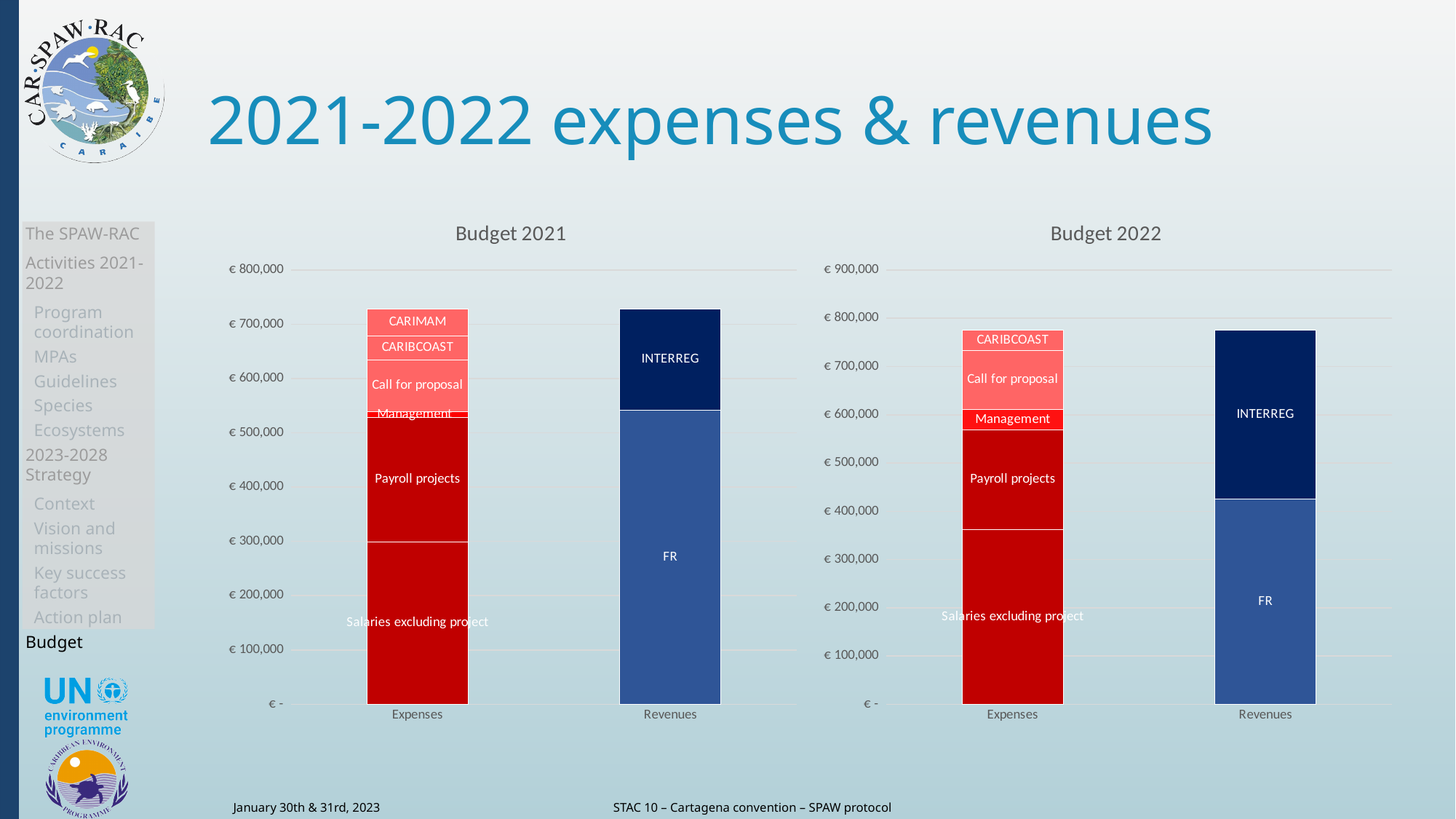
In the Budget 2021 chart, how many segments make up the Expenses bar? 6 In the Budget 2022 chart, is the FR segment of the Revenues bar greater or less than € 400,000? greater What kind of chart is the Budget 2021 chart? Stacked bar chart In the Budget 2021 chart, is the FR segment of the Revenues bar greater or less than € 600,000? less In the Budget 2022 chart, which two segments make up the Revenues bar? FR and INTERREG What is the highest value shown on the y axis of the Budget 2022 chart? € 900,000 In the Budget 2022 chart, is the total of the Revenues bar greater or less than € 800,000? less How many categories are shown on the x axis of the Budget 2022 chart? 2 Which expense segment appears in the Budget 2021 chart but not in the Budget 2022 chart? CARIMAM In the Budget 2022 chart, how many segments make up the Expenses bar? 5